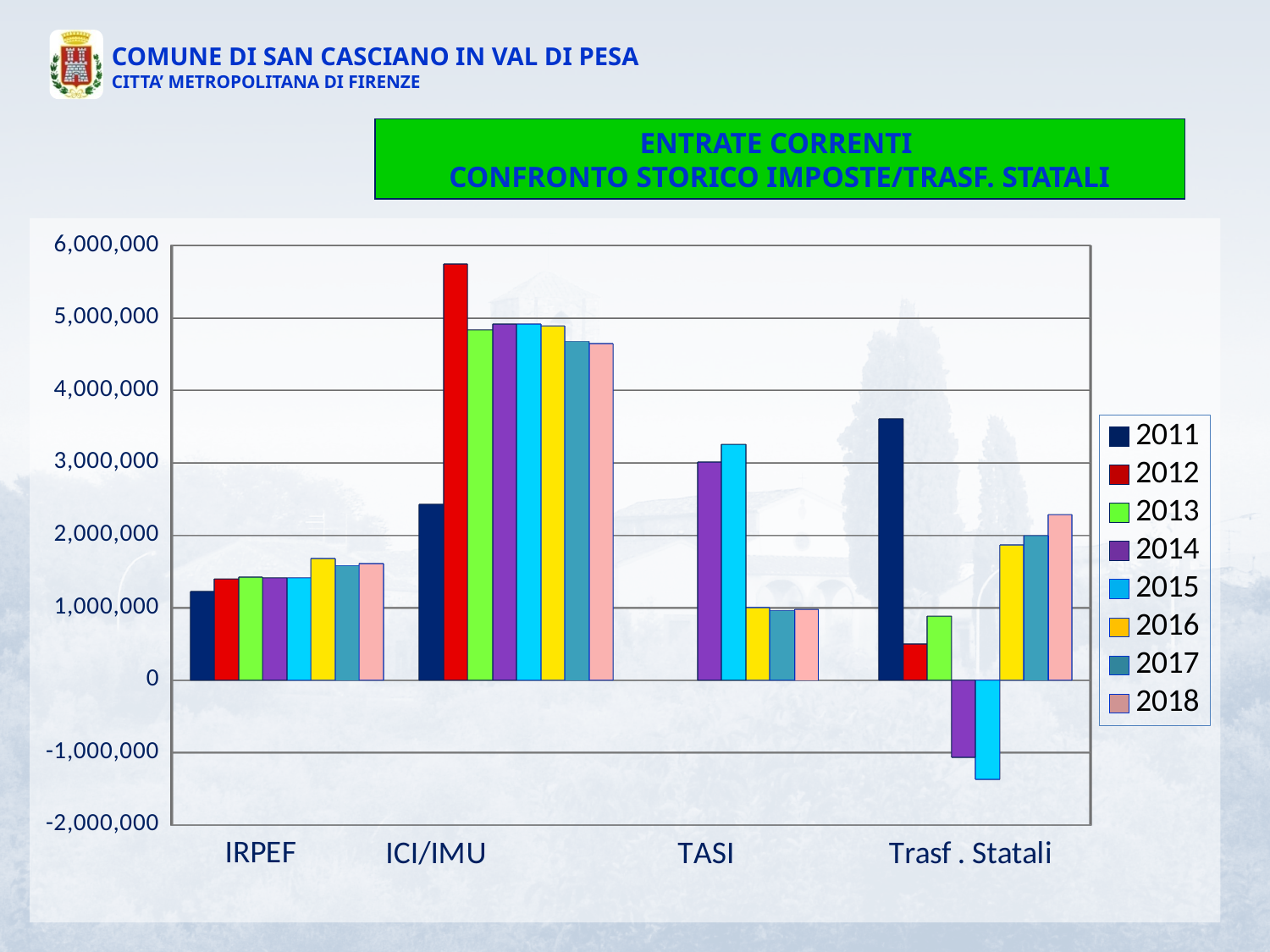
Is the value for ICI/IMU in 2012 greater or less than 5,000,000? greater Which year has the lowest value for Trasf. Statali? 2015 Which is larger: the value for TASI in 2014 or the value for TASI in 2016? TASI in 2014 Is the value for Trasf. Statali in 2011 greater or less than 3,000,000? greater Which year has the highest value for ICI/IMU? 2012 How many categories are shown on the x axis? 4 Is the value for Trasf. Statali in 2015 greater or less than -1,000,000? less Do the values for Trasf. Statali rise or fall from 2015 to 2018? rise Which colour represents the 2012 series in the legend? red What kind of chart is shown on the slide? bar chart How many series does the legend list? 8